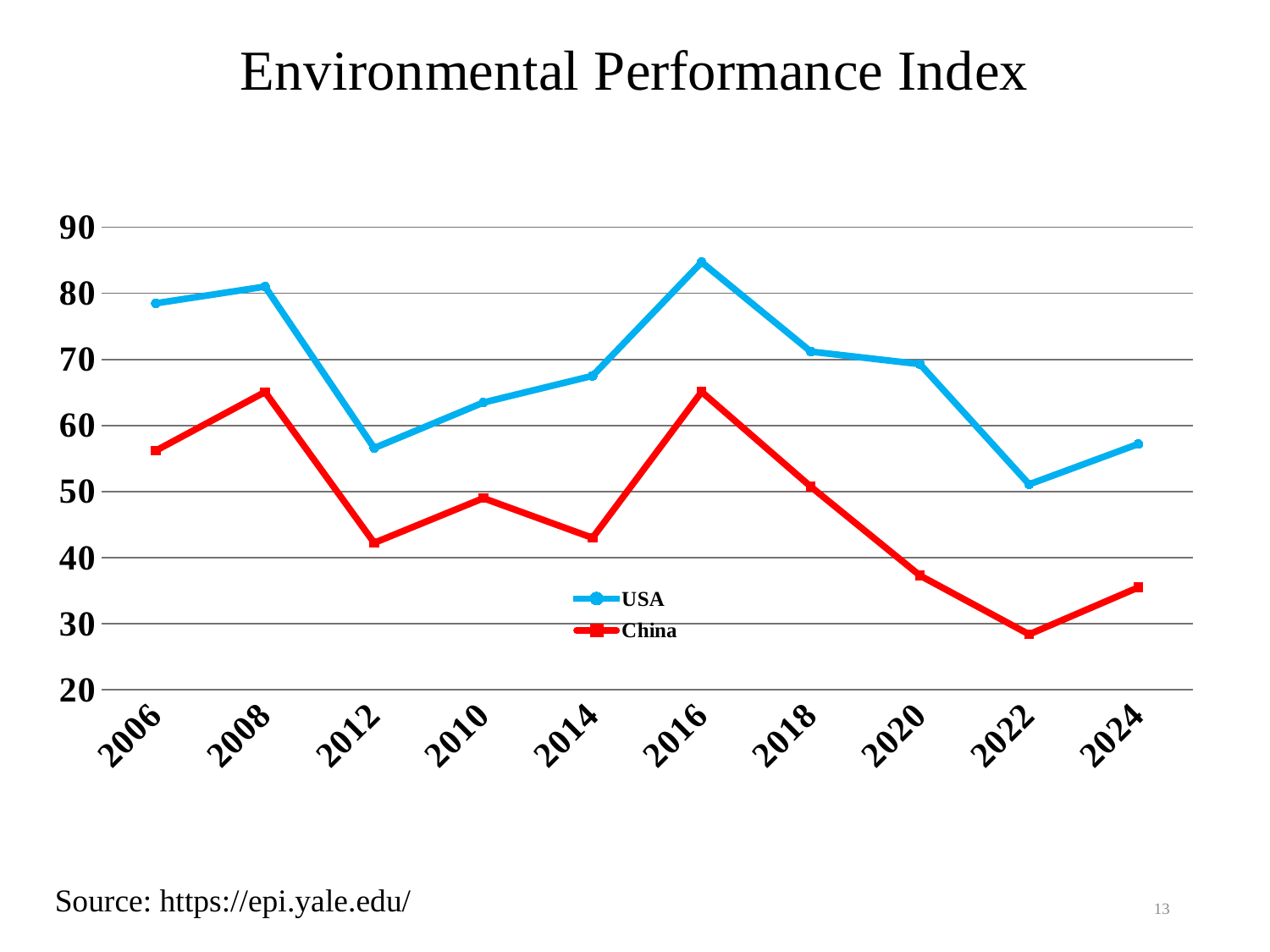
What kind of chart is shown on the slide? line chart Is the value for China in 2020 greater or less than 40? less In which year does the China series reach its lowest value? 2022 Is the value for China in 2022 greater or less than 30? less Which series has the larger value in 2016, USA or China? USA In which year does the USA series reach its lowest value? 2022 How many years are plotted along the x axis? 10 Does the USA series rise or fall between 2020 and 2022? fall In which year does the USA series reach its highest value? 2016 How many series does the legend list? 2 What is the title of the chart? Environmental Performance Index Is the value for USA in 2016 greater or less than 80? greater